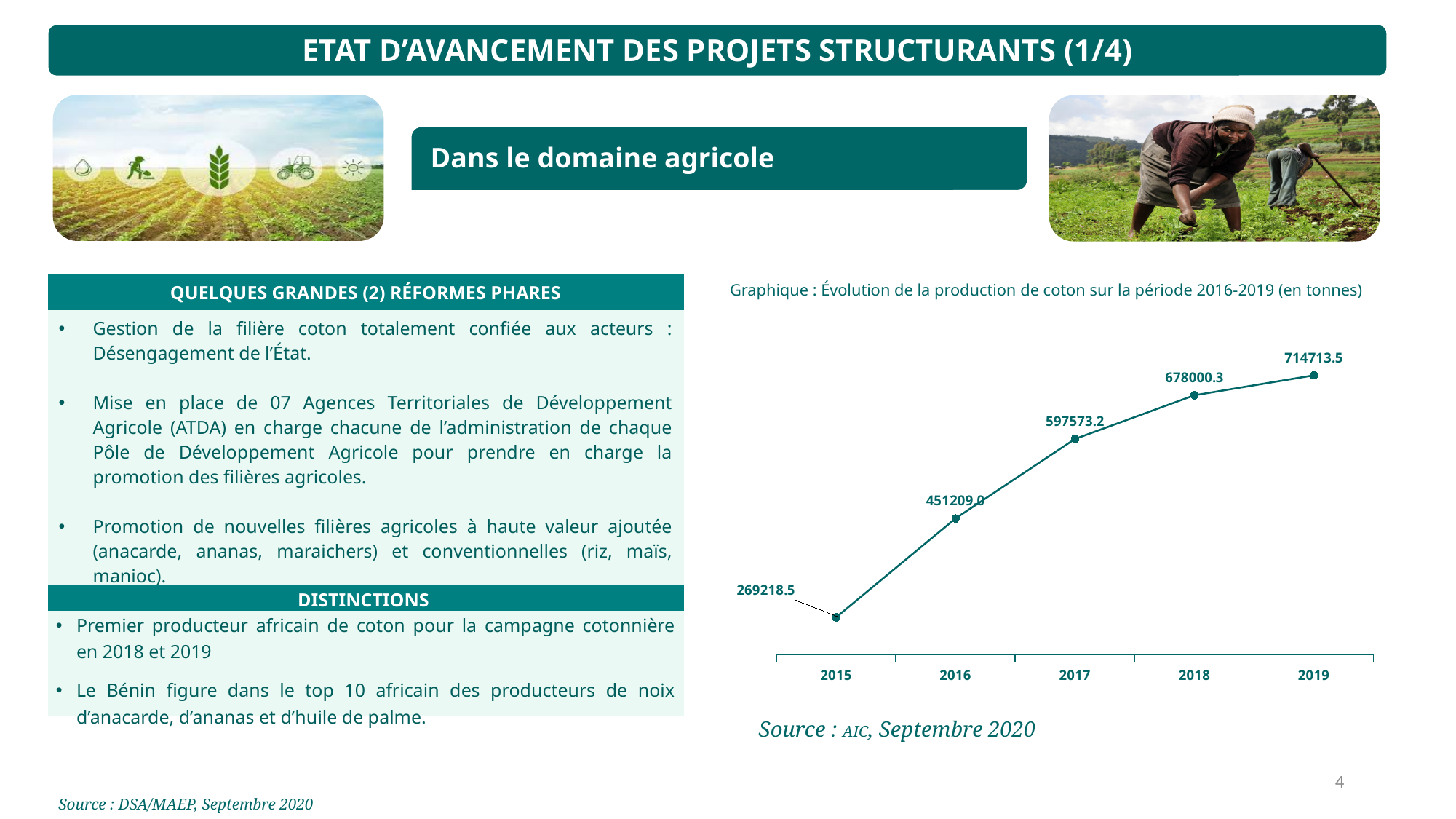
What was the cotton production in 2019? 714713.5 How many years are plotted on the chart? 5 What is the difference in cotton production between 2016 and 2015? 181990.5 What type of chart is shown on the slide? line chart What was the cotton production in 2015? 269218.5 What was the cotton production in 2017? 597573.2 Which year had higher cotton production, 2016 or 2017? 2017 What is the difference in cotton production between 2019 and 2018? 36713.2 Which year has the lowest cotton production? 2015 Does cotton production rise or fall from 2015 to 2019? rise Which year has the highest cotton production? 2019 What was the cotton production in 2018? 678000.3